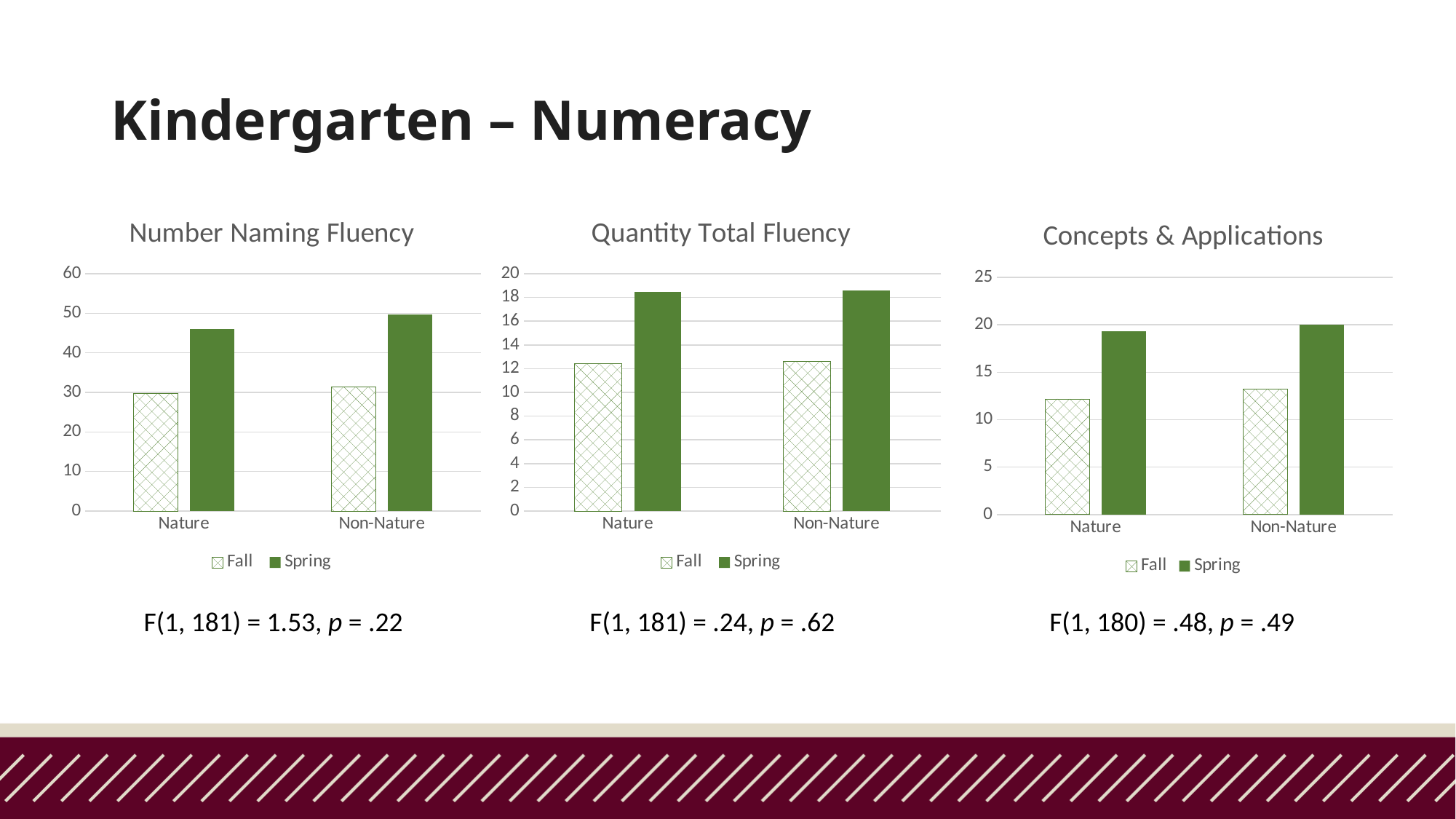
In the Quantity Total Fluency chart, is the Spring value for Non-Nature greater or less than 20? less In the Concepts & Applications chart, which is larger for Non-Nature, the Fall value or the Spring value? Spring What kind of chart is the Number Naming Fluency chart? bar chart In the Number Naming Fluency chart, is the Spring value for Nature greater or less than 40? greater In the Quantity Total Fluency chart, which is larger for Nature, the Fall value or the Spring value? Spring In the Quantity Total Fluency chart, how many categories are shown on the x axis? 2 In the Number Naming Fluency chart, which bar is the highest? Non-Nature Spring In the Concepts & Applications chart, is the Fall value for Nature greater or less than 10? greater What are the two legend entries in the Concepts & Applications chart? Fall and Spring In the Number Naming Fluency chart, how many series does the legend list? 2 In the Number Naming Fluency chart, which is larger for Non-Nature, the Fall value or the Spring value? Spring